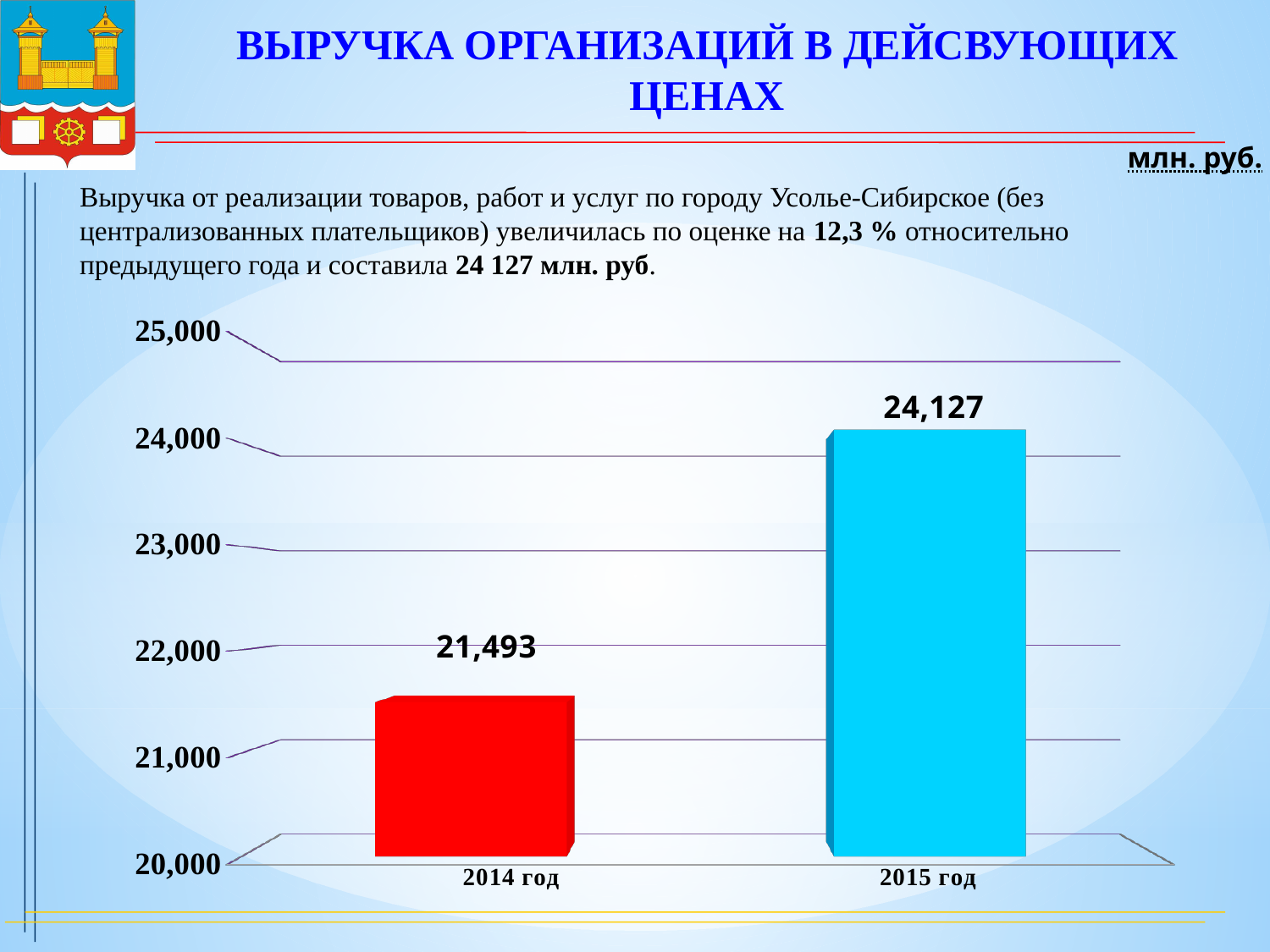
Do the values rise or fall from 2014 год to 2015 год? rise What is the value for 2014 год? 21,493 What is the value for 2015 год? 24,127 Which year has the highest value? 2015 год What kind of chart is shown on the slide? bar chart Which is larger, the value for 2014 год or the value for 2015 год? 2015 год Is the value for 2014 год greater or less than 22,000? less Which year has the lowest value? 2014 год Is the value for 2015 год greater or less than 24,000? greater How many categories are shown on the x axis? 2 What colour is the bar for 2014 год? red What is the difference between the values for 2015 год and 2014 год? 2,634